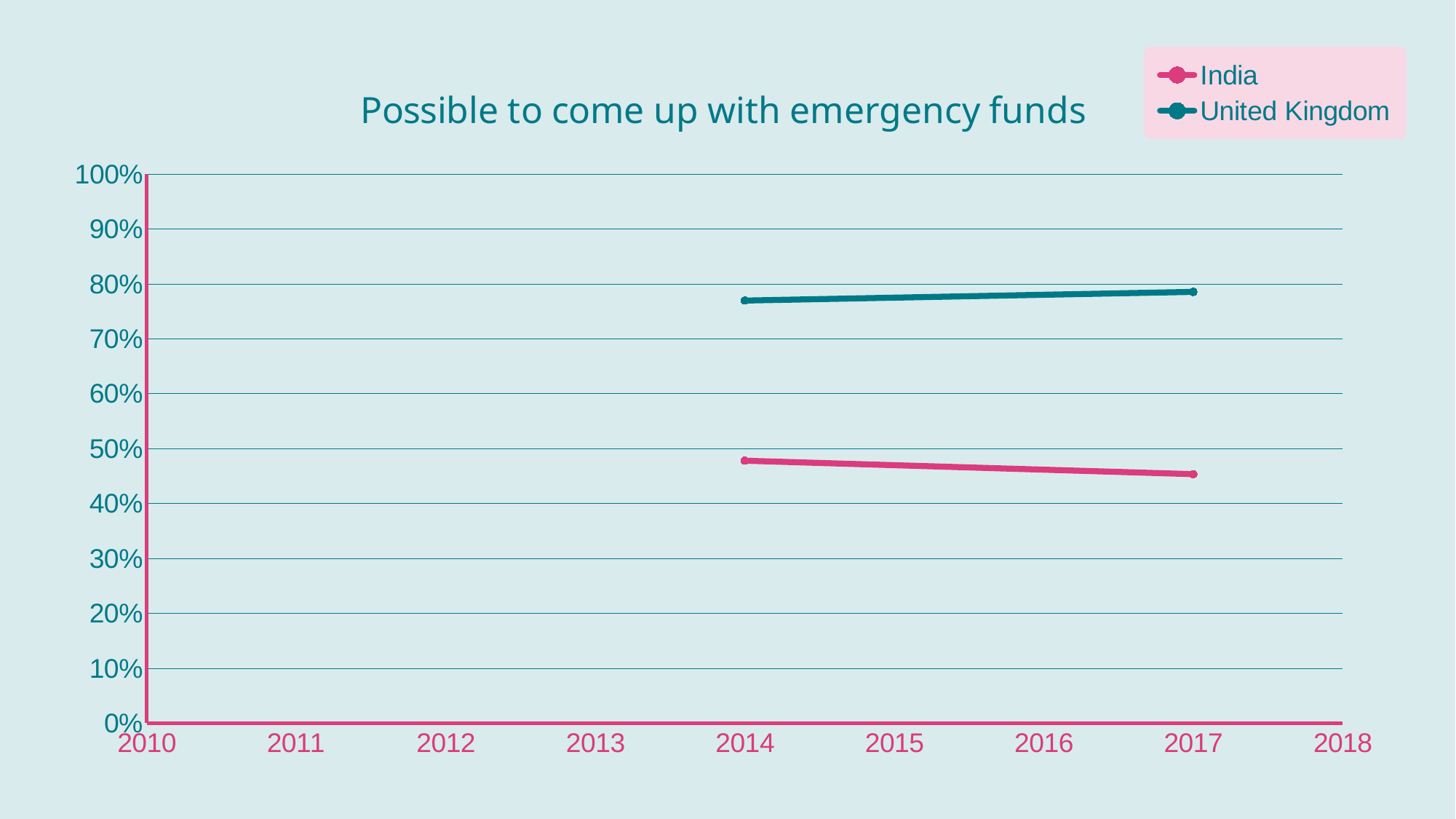
How many series does the legend list? 2 Which series has the higher value in 2017, India or United Kingdom? United Kingdom Is the value for United Kingdom in 2014 greater or less than 70%? greater Which series is drawn in pink? India Which series has the lower value in 2014, India or United Kingdom? India What is the title of the chart? Possible to come up with emergency funds What kind of chart is shown on the slide? line chart Is the value for India in 2017 greater or less than 50%? less How many data points are plotted for the India series? 2 Is the value for United Kingdom in 2017 greater or less than 80%? less Do the values for United Kingdom rise or fall from 2014 to 2017? rise Do the values for India rise or fall from 2014 to 2017? fall